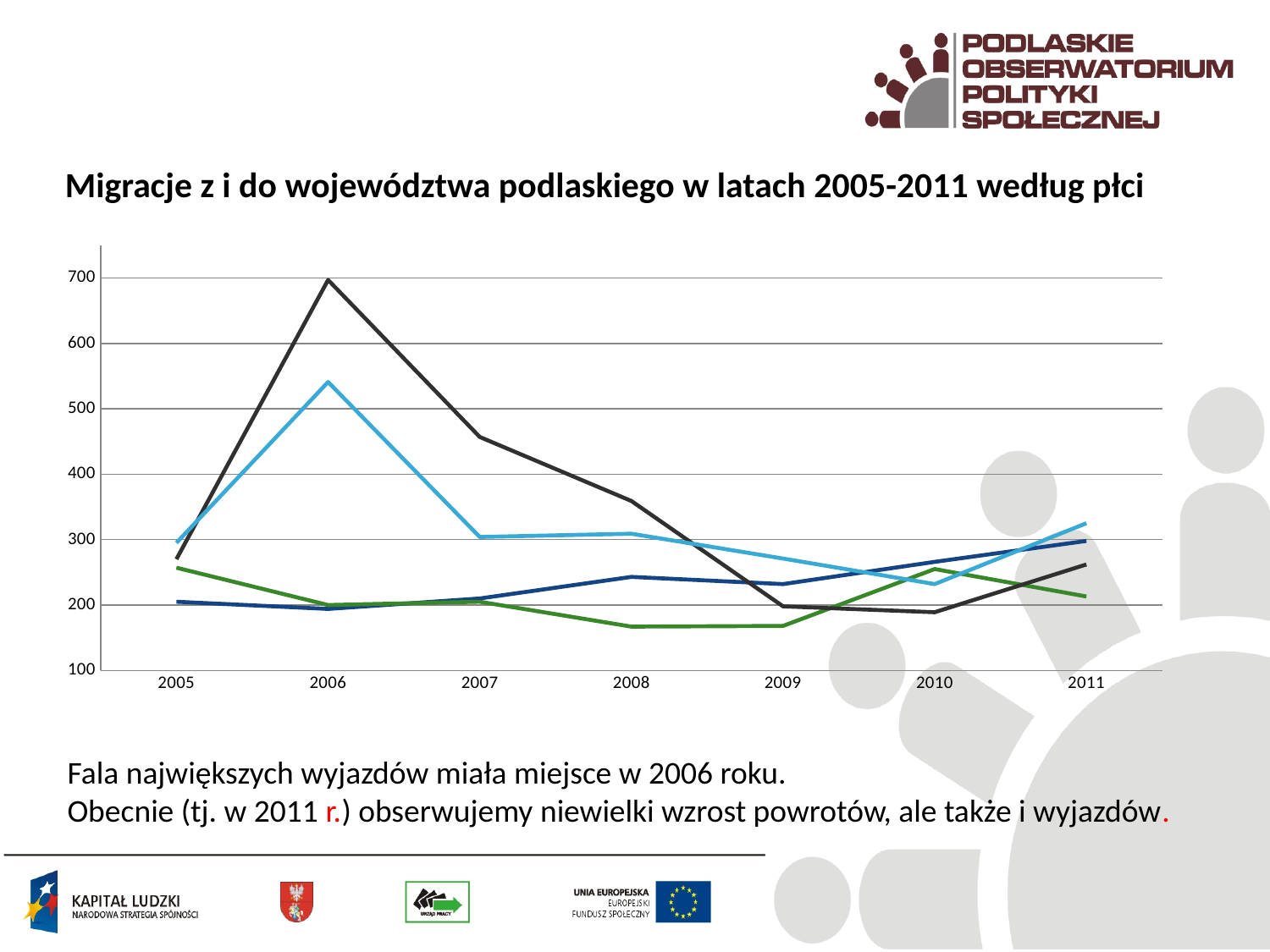
Is the value of the black line in 2006 greater or less than 600? greater In which year does the black line reach its highest value? 2006 Is the value of the black line in 2009 greater or less than 300? less In which year is the light blue line at its lowest value? 2010 Is the value of the green line in 2008 greater or less than 200? less Does the dark blue line rise or fall between 2009 and 2011? rise What is the title of the chart? Migracje z i do województwa podlaskiego w latach 2005-2011 według płci How many years are shown on the x axis of the chart? 7 In 2006, which line has the larger value, the black line or the light blue line? black line Does the black line rise or fall between 2006 and 2009? fall What kind of chart is shown on the slide? line chart